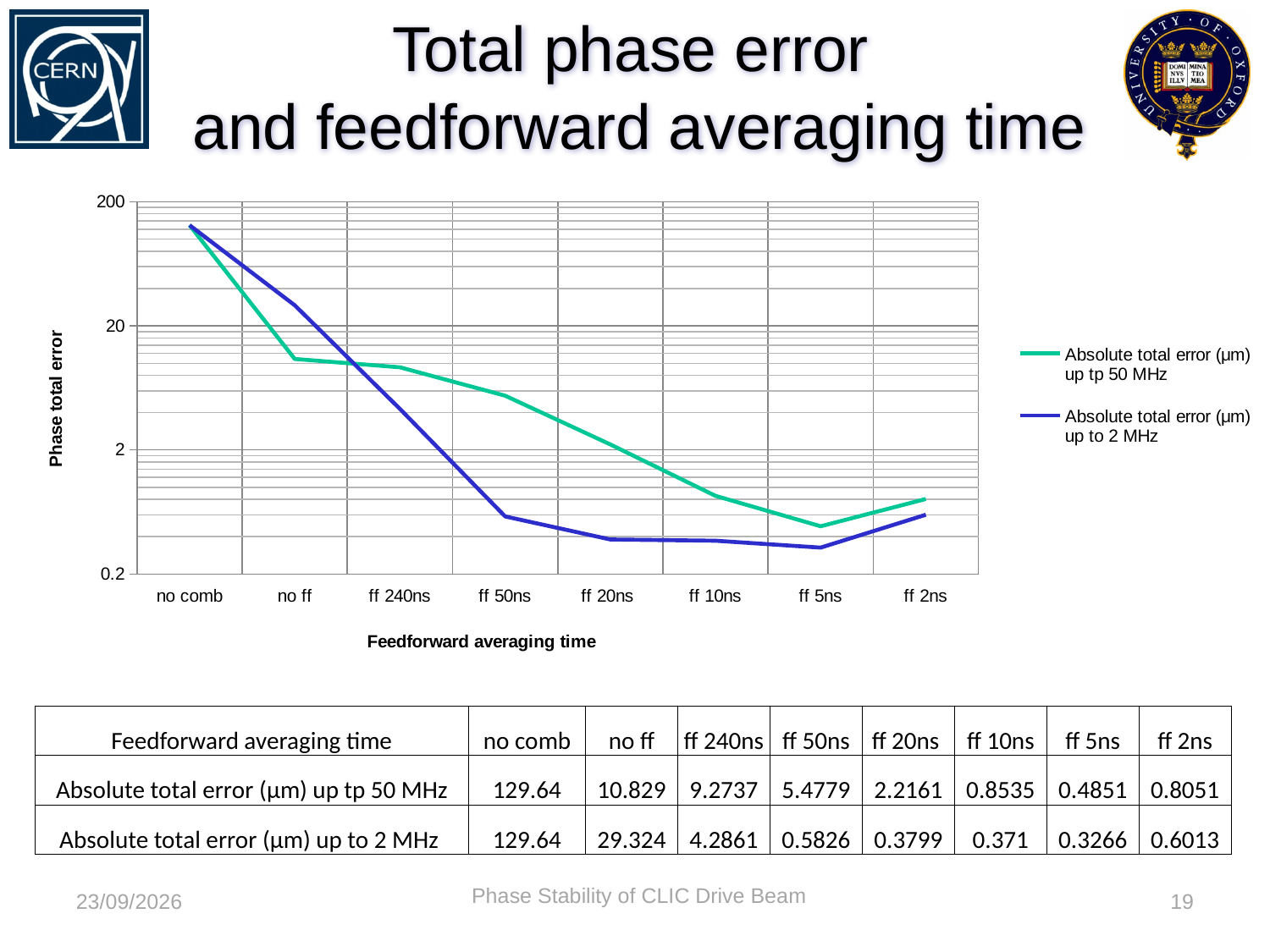
What is the absolute total error (µm) up to 2 MHz for no ff? 29.324 Is the absolute total error (µm) up to 2 MHz for ff 10ns greater or less than 2? less How many feedforward averaging time categories are plotted along the x axis? 8 What is the absolute total error (µm) up tp 50 MHz for no comb? 129.64 How many series does the chart legend list? 2 What is the difference between the 2 MHz and 50 MHz absolute total error values at no ff? 18.495 What is the absolute total error (µm) up tp 50 MHz for ff 50ns? 5.4779 What type of chart is shown on the slide? Line chart Which category has the highest absolute total error (µm) up tp 50 MHz? no comb At ff 50ns, which series has the larger value: up tp 50 MHz or up to 2 MHz? Absolute total error (µm) up tp 50 MHz What is the label of the x axis of the chart? Feedforward averaging time Which category has the lowest absolute total error (µm) up to 2 MHz? ff 5ns